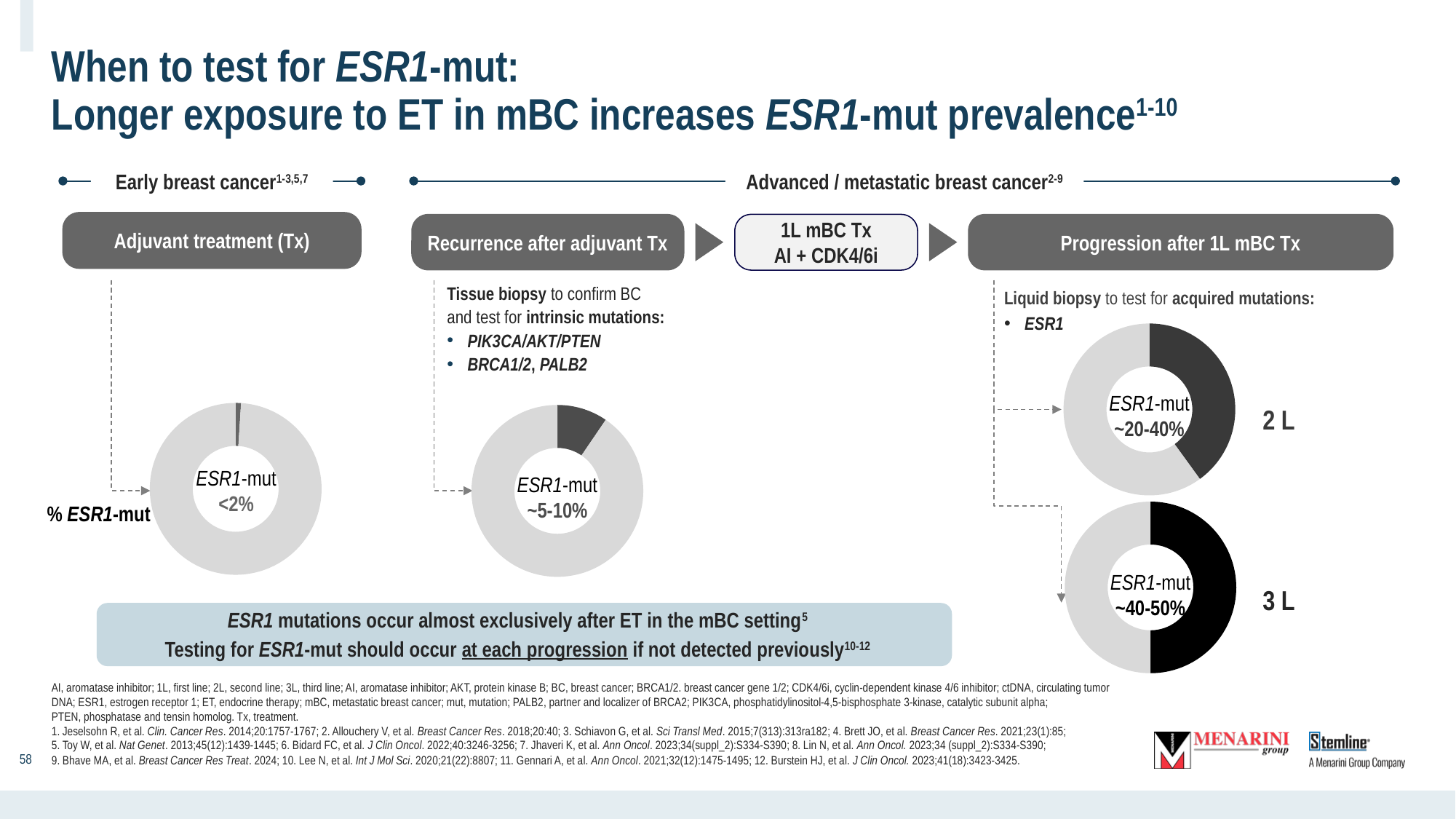
In the donut chart under 'Adjuvant treatment (Tx)', what ESR1-mut percentage is printed? <2% How many donut charts are shown on the slide? 4 In the donut chart labelled '2 L', what ESR1-mut percentage is printed? ~20-40% Does ESR1-mut prevalence rise or fall moving from adjuvant treatment to 3L mBC treatment across the donut charts? Rise What label is printed to the left of the adjuvant treatment donut chart? % ESR1-mut In the donut chart labelled '3 L', what ESR1-mut percentage is printed? ~40-50% Which donut chart shows the highest ESR1-mut prevalence? 3 L What kind of charts are used on the slide to show ESR1-mut prevalence? Donut (pie) charts In the donut chart under 'Recurrence after adjuvant Tx', what ESR1-mut percentage is printed? ~5-10% Which has the larger ESR1-mut share, the '2 L' donut chart or the '3 L' donut chart? 3 L Which donut chart shows the lowest ESR1-mut prevalence? Adjuvant treatment (Tx) What colour is the ESR1-mut slice in the '3 L' donut chart? Black